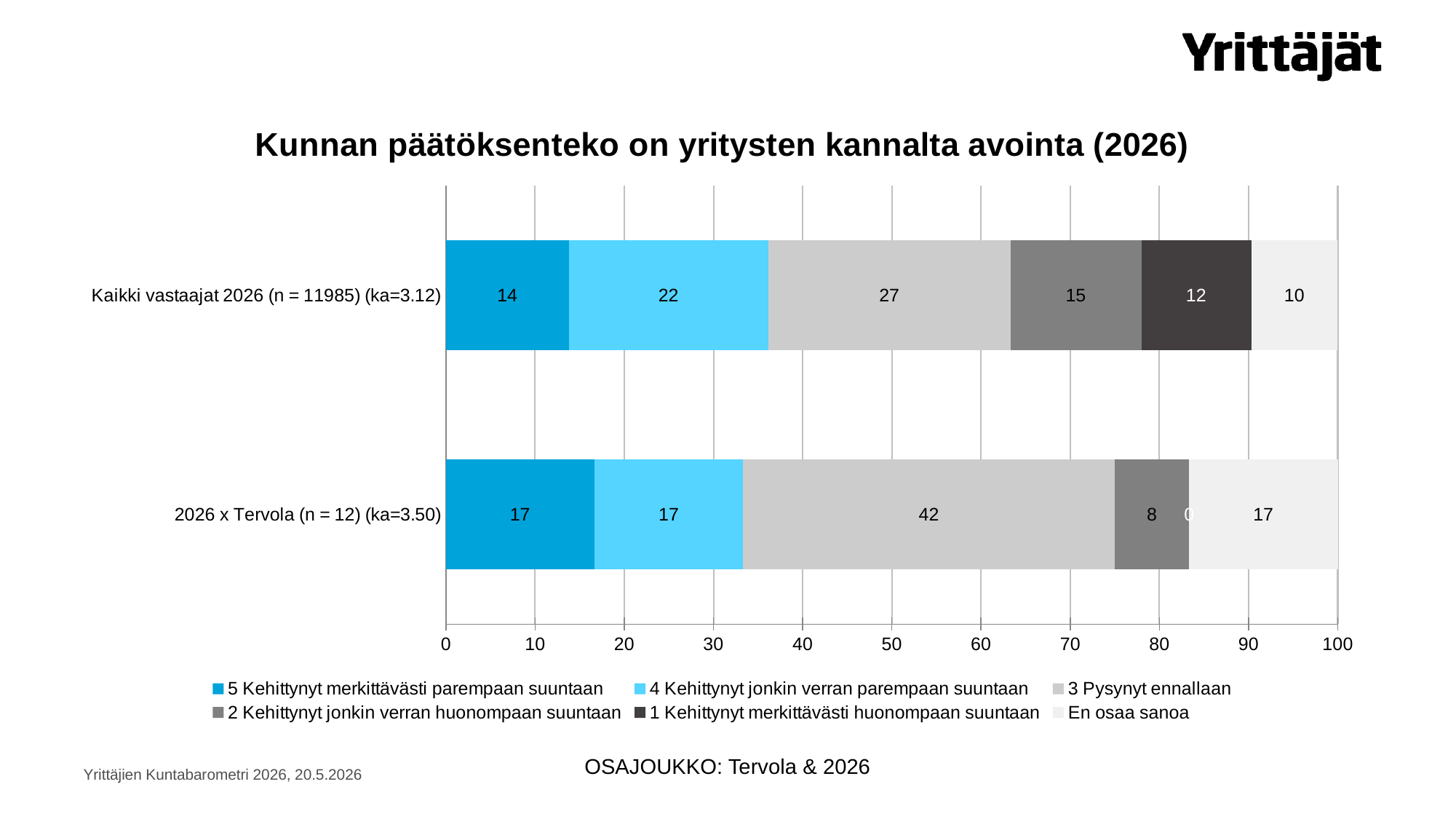
What is the difference between the "3 Pysynyt ennallaan" values for "2026 x Tervola (n = 12) (ka=3.50)" and "Kaikki vastaajat 2026 (n = 11985) (ka=3.12)"? 15 What is the value of "En osaa sanoa" for "2026 x Tervola (n = 12) (ka=3.50)"? 17 How many categories (bars) are shown on the chart? 2 What is the value of "2 Kehittynyt jonkin verran huonompaan suuntaan" for "2026 x Tervola (n = 12) (ka=3.50)"? 8 Which series has the smallest value in the "Kaikki vastaajat 2026 (n = 11985) (ka=3.12)" bar? En osaa sanoa How many series does the legend list? 6 What is the value of "3 Pysynyt ennallaan" for "Kaikki vastaajat 2026 (n = 11985) (ka=3.12)"? 27 Which series has the largest value in the "2026 x Tervola (n = 12) (ka=3.50)" bar? 3 Pysynyt ennallaan What is the value of "1 Kehittynyt merkittävästi huonompaan suuntaan" for "Kaikki vastaajat 2026 (n = 11985) (ka=3.12)"? 12 What kind of chart is shown on the slide? Stacked bar chart Which is larger: "4 Kehittynyt jonkin verran parempaan suuntaan" for "Kaikki vastaajat 2026 (n = 11985) (ka=3.12)" or for "2026 x Tervola (n = 12) (ka=3.50)"? Kaikki vastaajat 2026 (n = 11985) (ka=3.12) What is the value of "3 Pysynyt ennallaan" for "2026 x Tervola (n = 12) (ka=3.50)"? 42